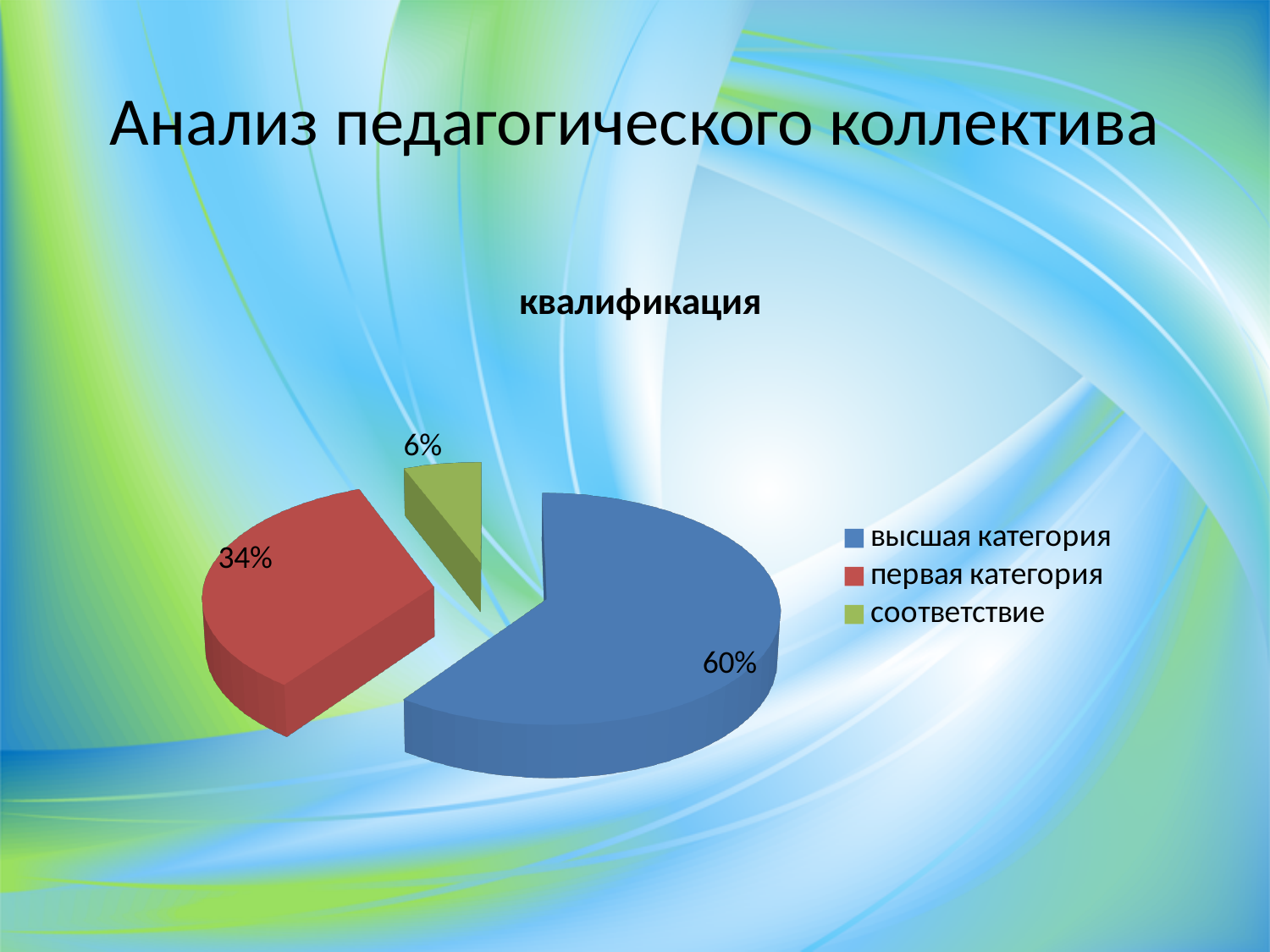
What is the difference between the shares of 'первая категория' and 'соответствие'? 28% What share of the pie does 'первая категория' have? 34% Which is larger, the share of 'первая категория' or the share of 'соответствие'? первая категория How many categories does the pie chart show? 3 Which category has the smallest share of the pie? соответствие What is the difference between the shares of 'высшая категория' and 'первая категория'? 26% What share of the pie does 'высшая категория' have? 60% Which colour represents 'первая категория' in the legend? red What type of chart is shown on the slide? pie chart What is the title of the chart? квалификация Which category has the largest share of the pie? высшая категория What share of the pie does 'соответствие' have? 6%